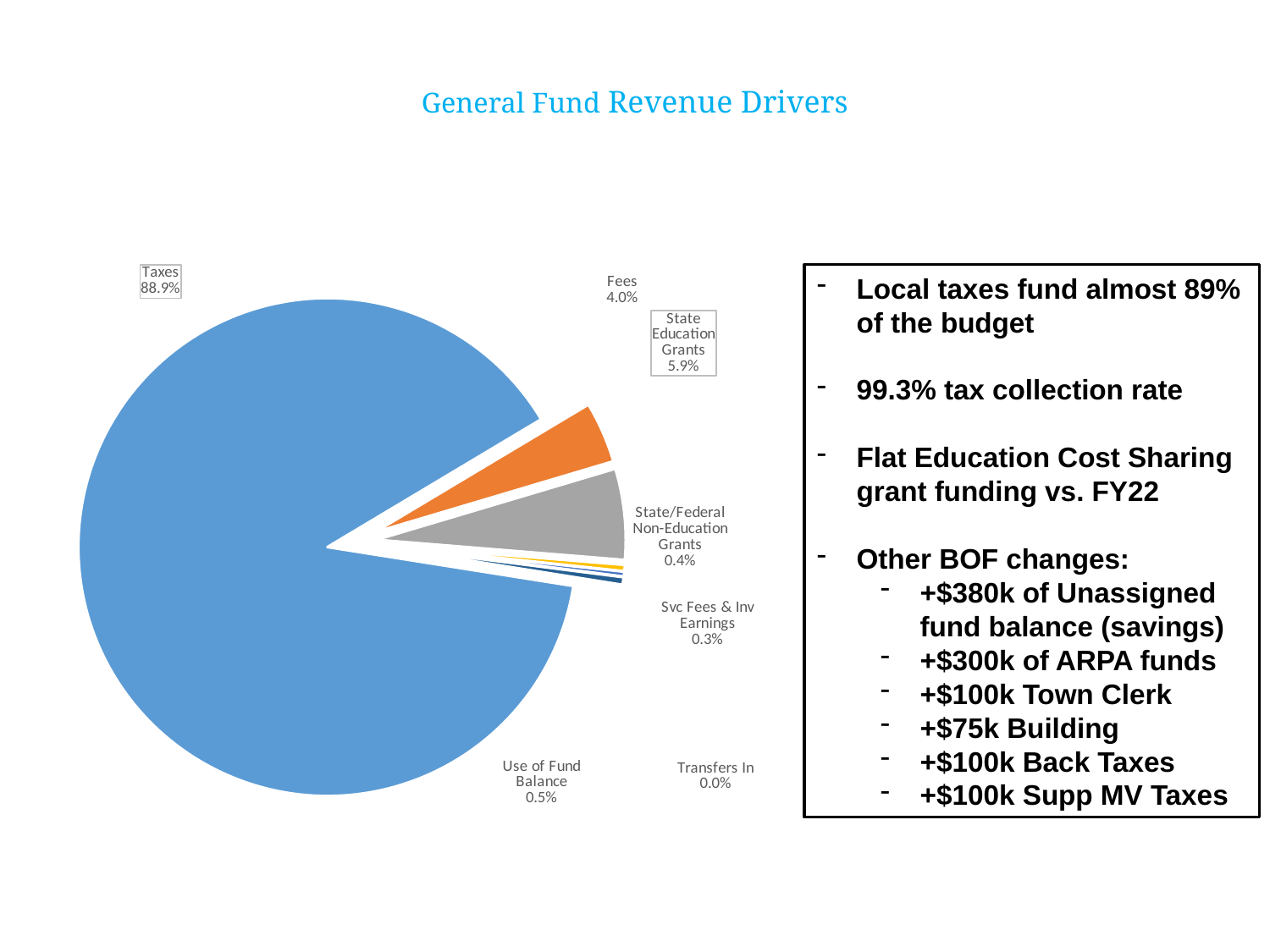
Which is larger, Fees or State Education Grants? State Education Grants What is the value shown for Transfers In? 0.0% What is the value shown for State Education Grants? 5.9% What kind of chart is shown on the slide? Pie chart What is the value shown for Use of Fund Balance? 0.5% Which category has the smallest slice of the pie? Transfers In What share of the pie does Taxes represent? 88.9% What is the difference between the Taxes share and the State Education Grants share? 83.0% How many categories are shown in the pie chart? 7 What is the title of the slide containing the chart? General Fund Revenue Drivers Which category has the largest slice of the pie? Taxes What is the value shown for Fees? 4.0%